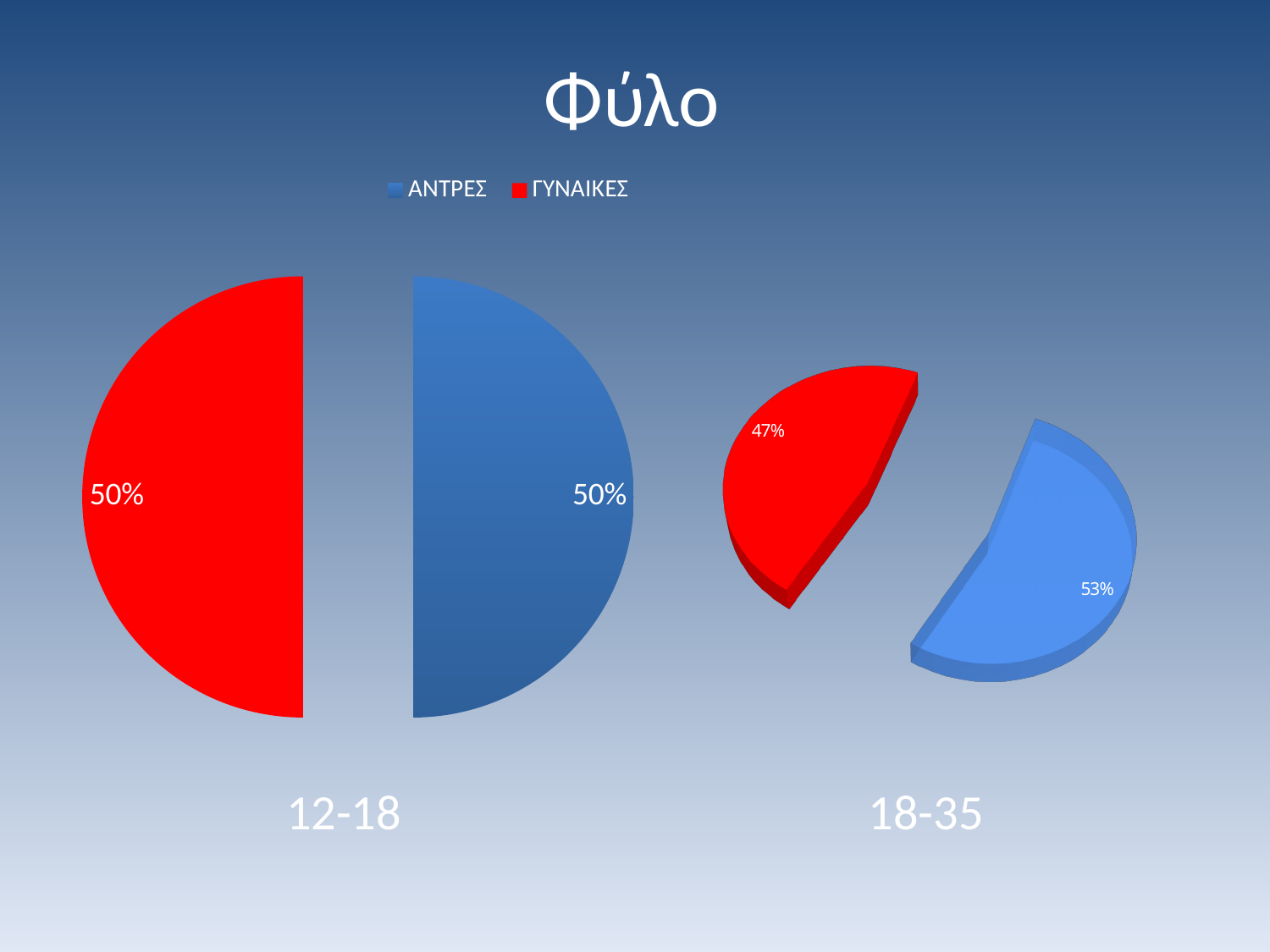
How many slices does the 18-35 pie chart have? 2 In the 12-18 pie chart, what share is labelled for ΓΥΝΑΙΚΕΣ? 50% What kind of chart is used for the 12-18 group? Pie chart Is the share of ΓΥΝΑΙΚΕΣ larger in the 12-18 pie chart or in the 18-35 pie chart? 12-18 In the 18-35 pie chart, what share is labelled for ΓΥΝΑΙΚΕΣ? 47% In the 18-35 pie chart, which category has the larger slice? ΑΝΤΡΕΣ In the 18-35 pie chart, what is the difference in percentage points between ΑΝΤΡΕΣ and ΓΥΝΑΙΚΕΣ? 6 percentage points In the 12-18 pie chart, what share is labelled for ΑΝΤΡΕΣ? 50% What is the title of the slide containing the charts? Φύλο In the 18-35 pie chart, what share is labelled for ΑΝΤΡΕΣ? 53% How many series does the legend list? 2 In the 18-35 pie chart, which category has the smaller slice? ΓΥΝΑΙΚΕΣ